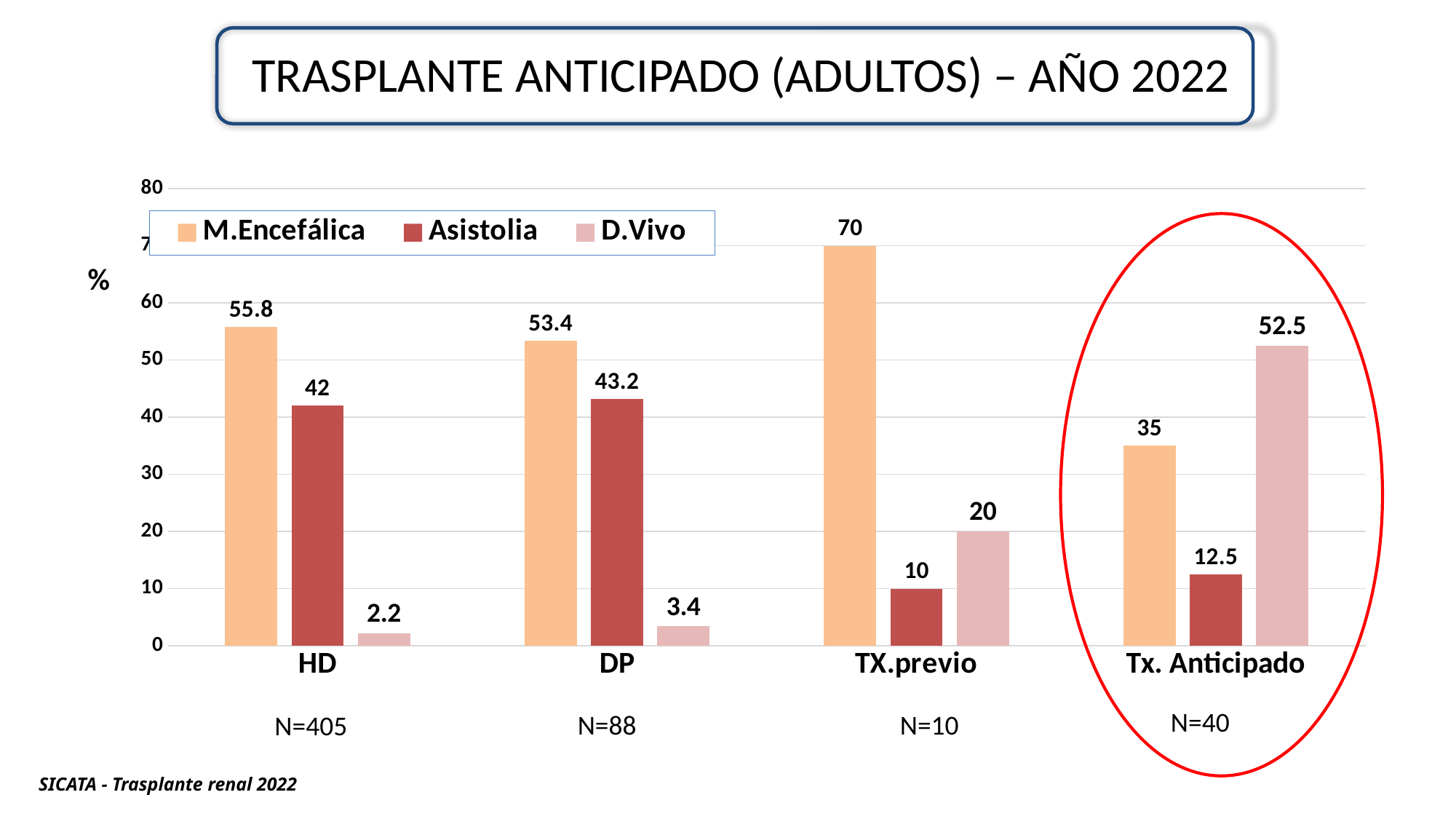
What is the D.Vivo value for Tx. Anticipado? 52.5 What is the N value shown under the Tx. Anticipado category? N=40 Is the Asistolia value for TX.previo greater or less than 20? less How many categories are shown on the x axis? 4 Which category has the highest M.Encefálica value? TX.previo What is the difference between the M.Encefálica and Asistolia values for HD? 13.8 What kind of chart is shown on the slide? bar chart What is the Asistolia value for DP? 43.2 Which category has the lowest D.Vivo value? HD For Tx. Anticipado, which is larger: M.Encefálica or D.Vivo? D.Vivo What is the M.Encefálica value for HD? 55.8 How many series does the legend list? 3